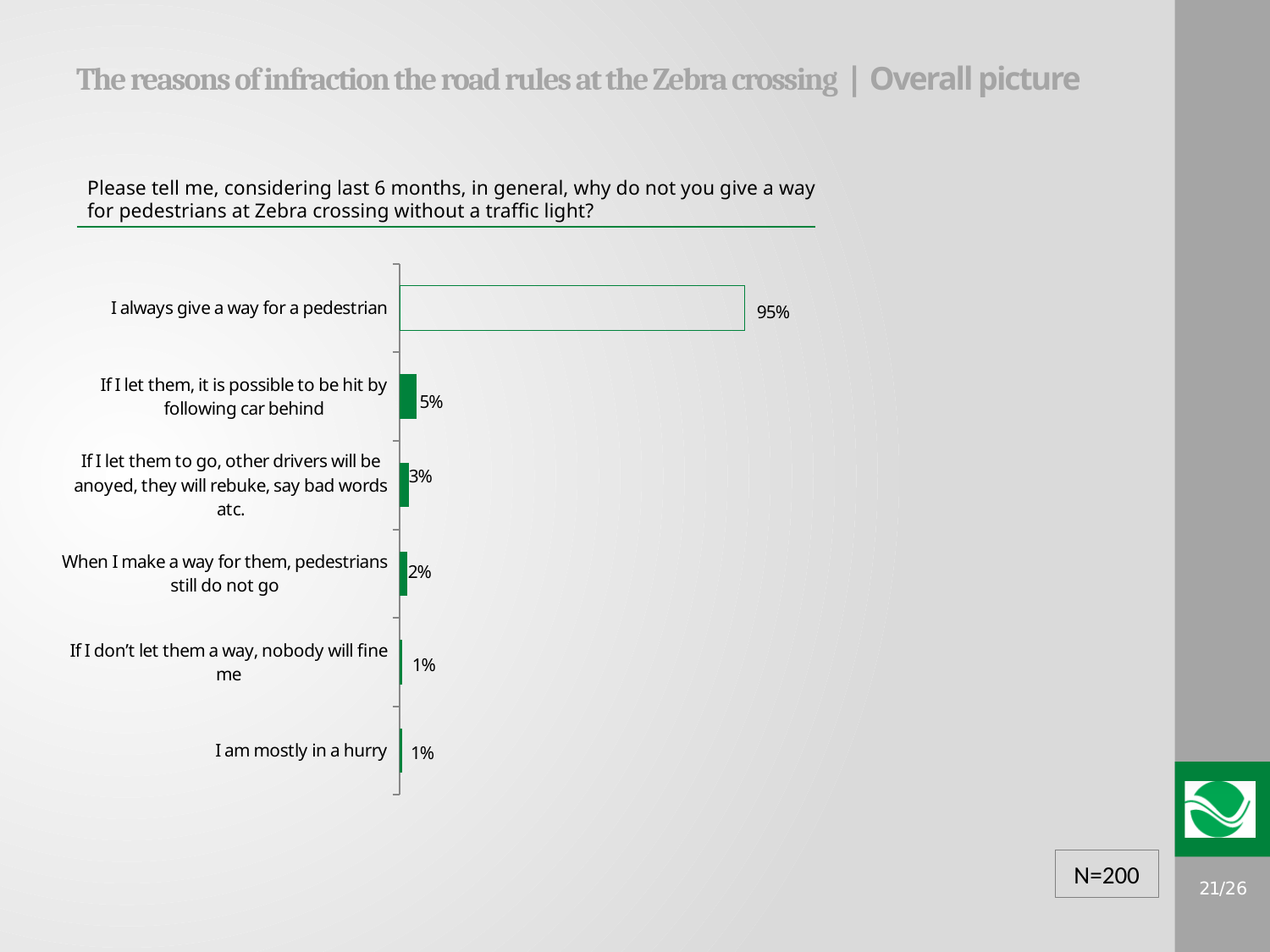
What is the title of the slide? The reasons of infraction the road rules at the Zebra crossing | Overall picture What is the difference between the values for "If I let them, it is possible to be hit by following car behind" and "If I let them to go, other drivers will be anoyed, they will rebuke, say bad words atc."? 2% What is the value for "I am mostly in a hurry"? 1% How many categories are shown in the chart? 6 Which is larger: the value for "If I let them to go, other drivers will be anoyed, they will rebuke, say bad words atc." or the value for "When I make a way for them, pedestrians still do not go"? If I let them to go, other drivers will be anoyed, they will rebuke, say bad words atc. What percentage of respondents said "I always give a way for a pedestrian"? 95% What kind of chart is shown on the slide? Bar chart Which category has the highest value? I always give a way for a pedestrian What sample size (N) is shown on the slide? N=200 What is the difference between "I always give a way for a pedestrian" and "If I let them, it is possible to be hit by following car behind"? 90% What is the value for "If I let them, it is possible to be hit by following car behind"? 5% What is the value for "When I make a way for them, pedestrians still do not go"? 2%